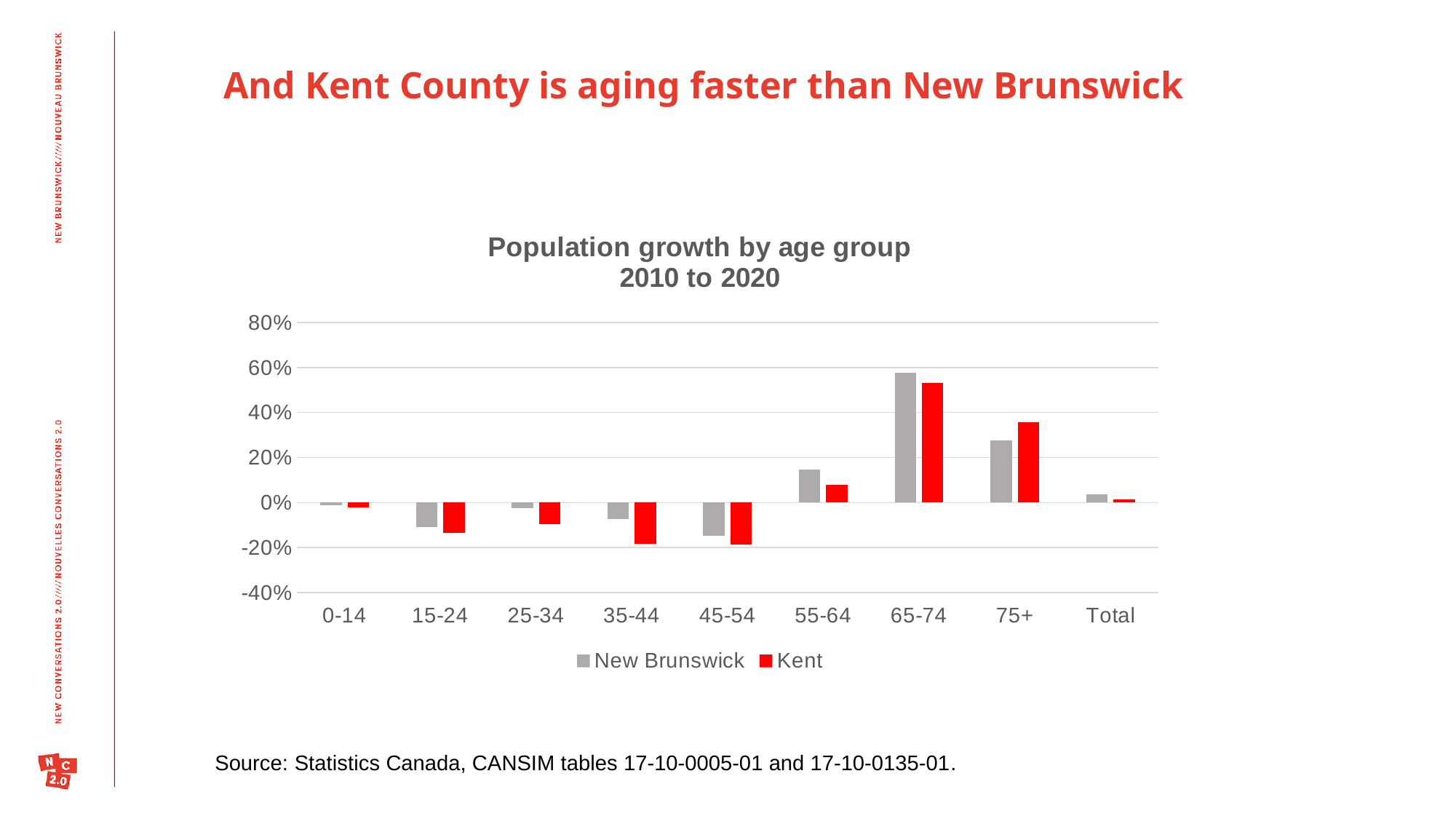
Which age group has the highest population growth for New Brunswick? 65-74 Which age group has the lowest population growth for New Brunswick? 45-54 What kind of chart is shown on the slide? bar chart Which age group has the highest population growth for Kent? 65-74 How many categories are shown along the x axis? 9 What colour are the bars for Kent? red For the 55-64 age group, which is larger: New Brunswick or Kent? New Brunswick Is the value for Kent in the 35-44 age group greater or less than 0%? less For the 75+ age group, which is larger: New Brunswick or Kent? Kent How many series does the legend list? 2 What is the title of the chart? Population growth by age group 2010 to 2020 Is the value for Kent in the 65-74 age group greater or less than 40%? greater